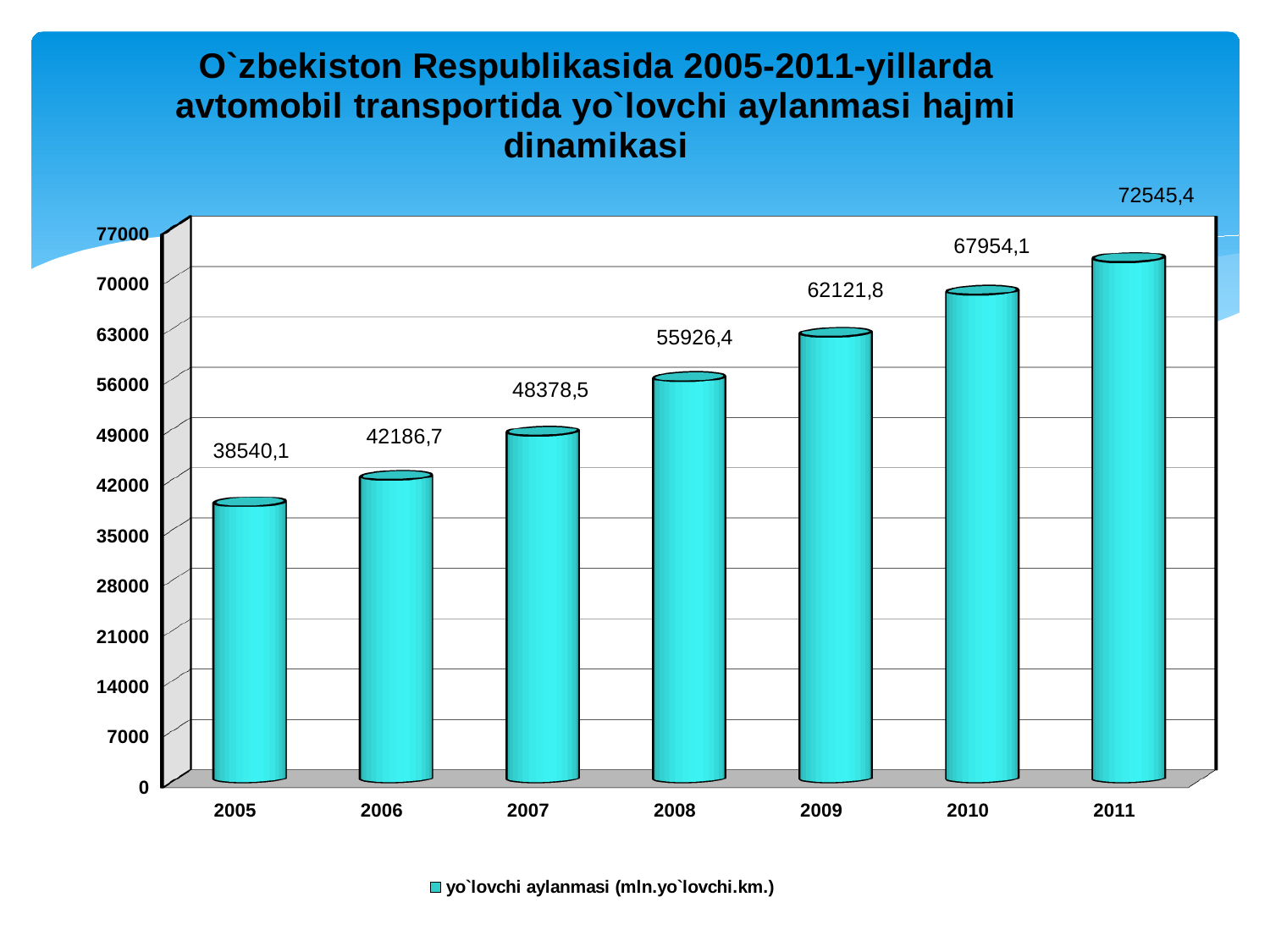
How many years are shown on the x axis? 7 What is the value for 2005? 38540,1 Do the values rise or fall from 2005 to 2011? rise What kind of chart is shown on the slide? bar chart What is the difference between the values for 2008 and 2007? 7547,9 What is the difference between the values for 2011 and 2005? 34005,3 Is the value for 2007 greater or less than 49000? less Which year has the lowest value? 2005 Which is larger, the value for 2009 or the value for 2010? 2010 What is the value for 2011? 72545,4 Which year has the highest value? 2011 What is the value for 2008? 55926,4